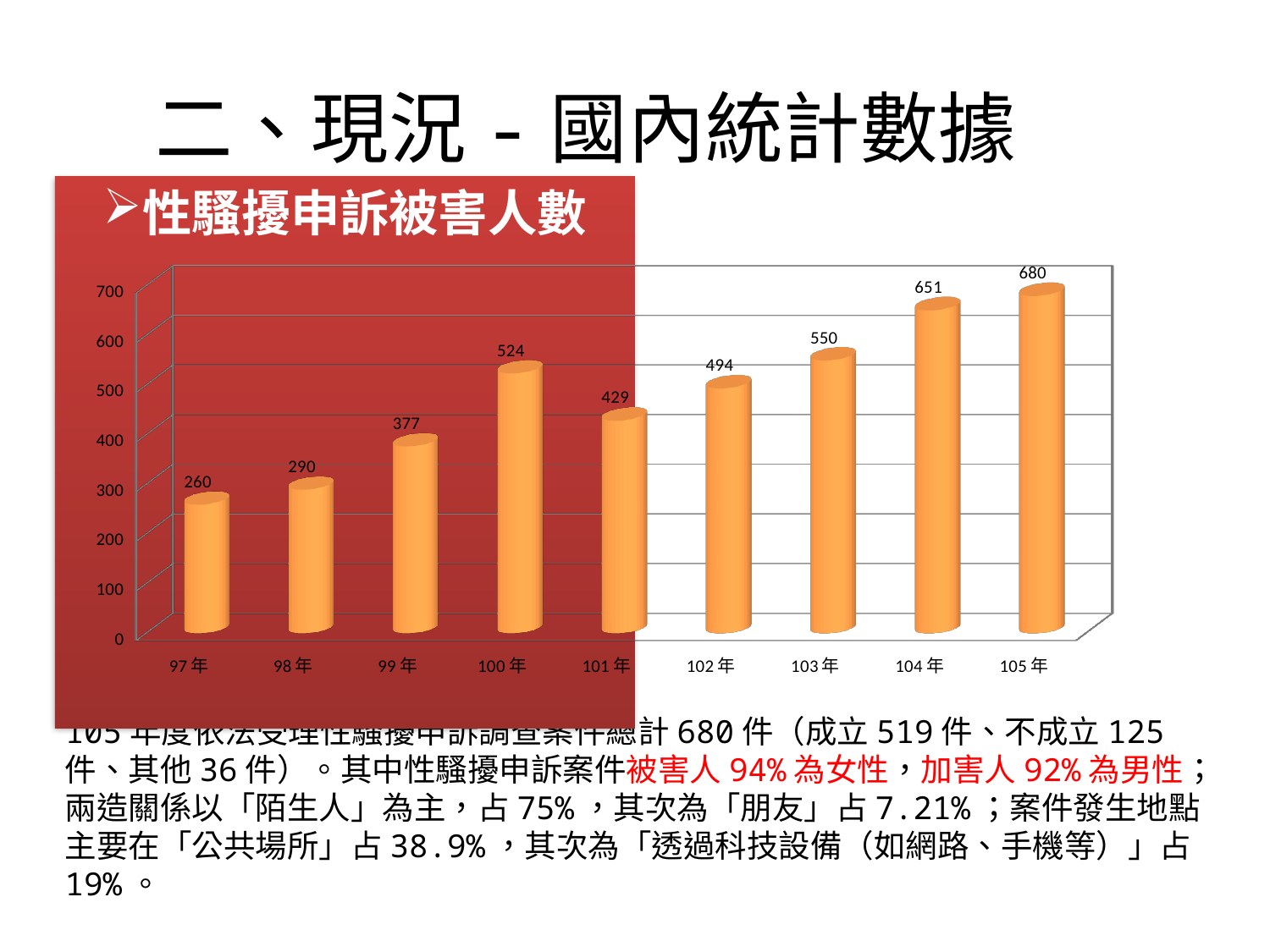
What is the difference between the values for 100年 and 101年? 95 Which year has the lowest value? 97年 Which year has the highest value? 105年 What is the title of the chart? 性騷擾申訴被害人數 What is the value for 105年? 680 What is the value for 97年? 260 What is the difference between the values for 105年 and 104年? 29 What is the value for 101年? 429 How many years are shown on the x axis? 9 What kind of chart is this? bar chart Is the value for 103年 greater or less than 500? greater Which is larger, the value for 100年 or the value for 101年? 100年